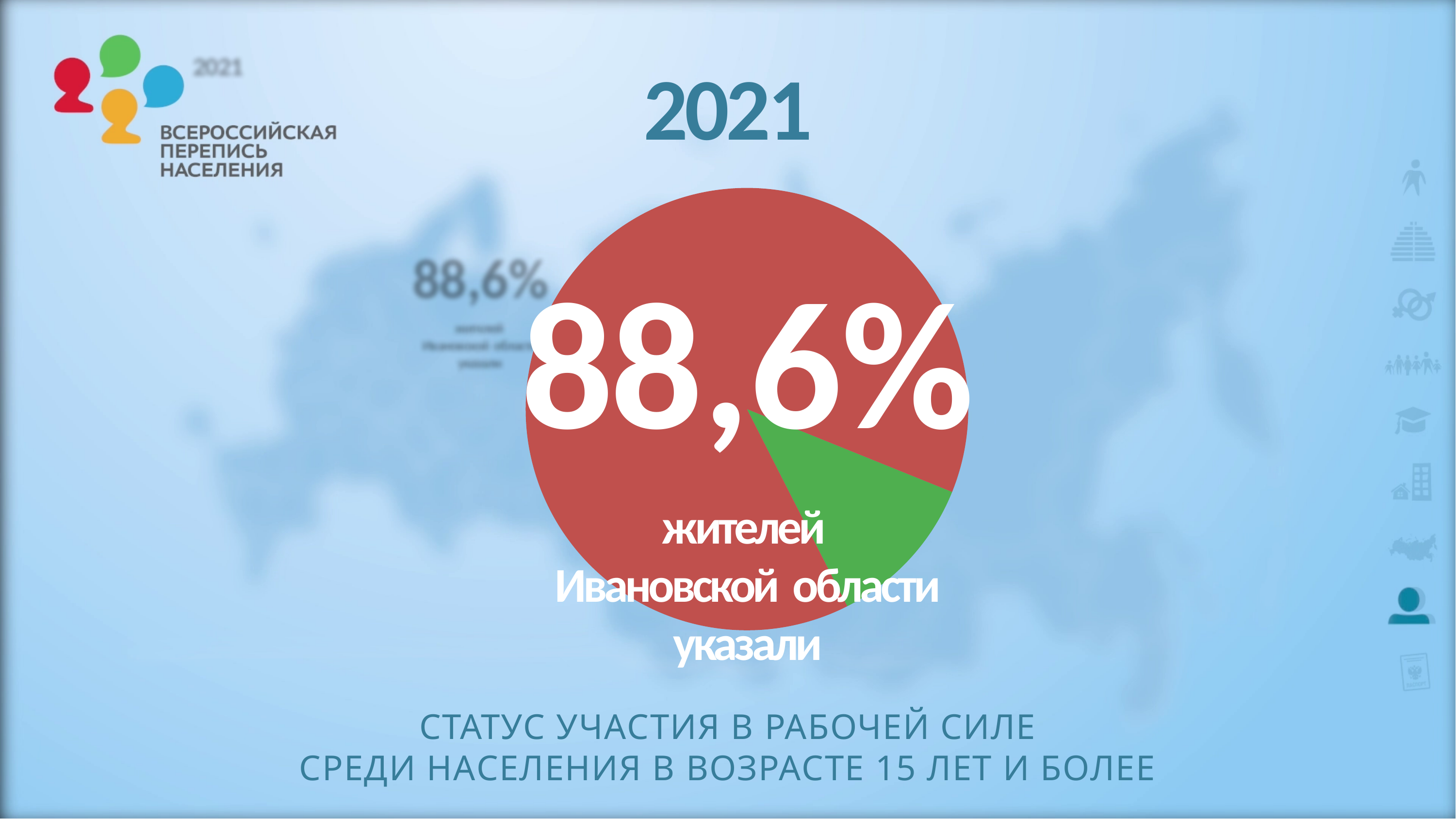
Which slice of the pie chart is larger, the red one or the green one? the red one What year is shown above the pie chart? 2021 How many slices does the pie chart have? 2 What is the value of the largest slice of the pie chart? 88,6% What is the title written below the pie chart? СТАТУС УЧАСТИЯ В РАБОЧЕЙ СИЛЕ СРЕДИ НАСЕЛЕНИЯ В ВОЗРАСТЕ 15 ЛЕТ И БОЛЕЕ What kind of chart is shown on the slide? pie chart Which slice of the pie chart is the smallest, the red one or the green one? the green one What percentage of residents of Ivanovo region (жителей Ивановской области) indicated their labour force participation status, according to the pie chart? 88,6%